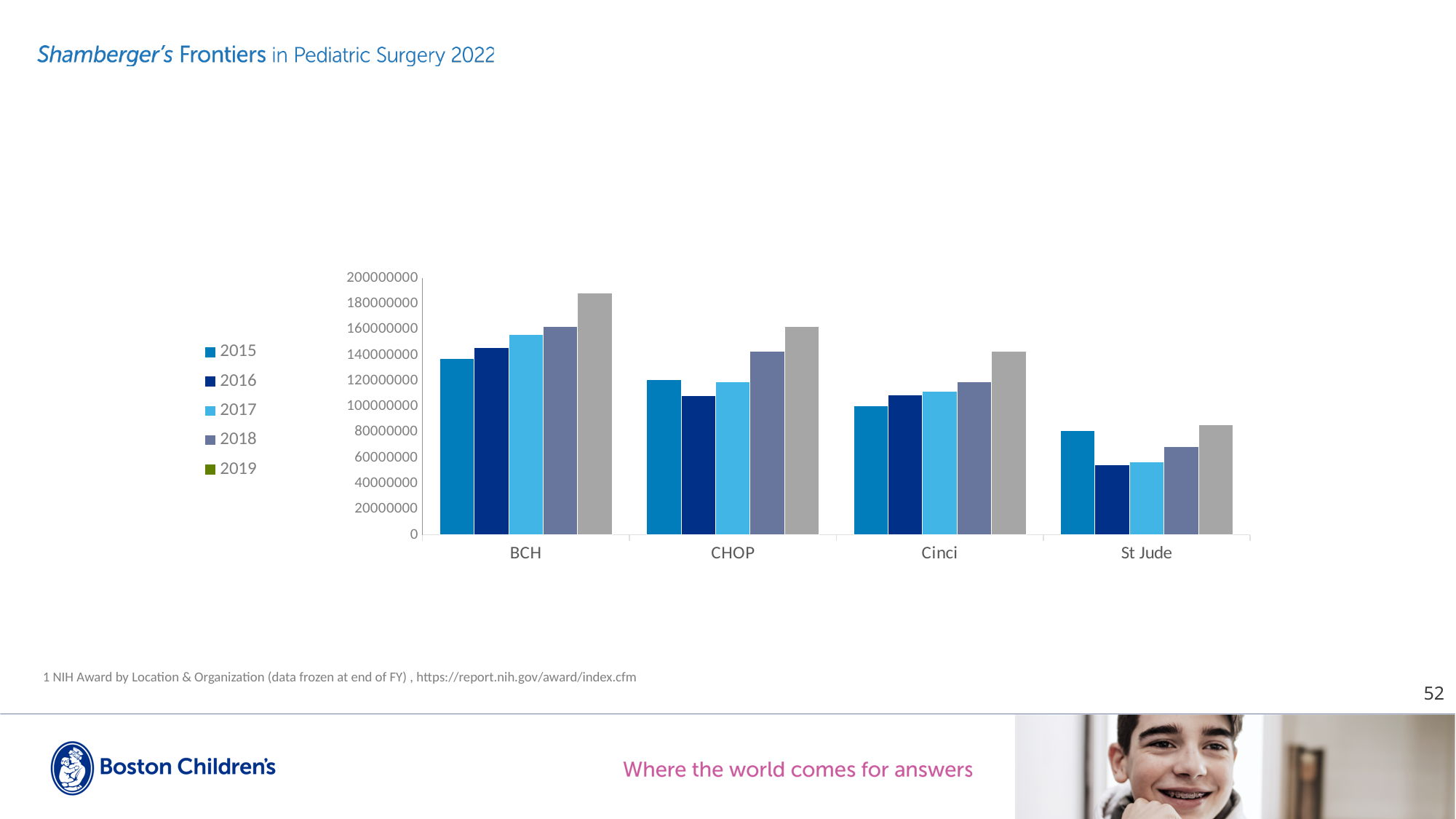
Which institution has the lowest bars overall? St Jude For BCH, which year has the highest value? 2019 Do the values for BCH rise or fall from 2015 to 2019? rise Is the 2016 value for St Jude greater or less than 60000000? less Which institution has the tallest bar in the chart? BCH What kind of chart is shown on the slide? bar chart Which is larger, the 2019 value for BCH or the 2019 value for CHOP? BCH How many institutions (categories) are shown on the x axis? 4 Is the 2019 value for Cinci greater or less than 120000000? greater Is the 2019 value for BCH greater or less than 180000000? greater How many series does the legend list? 5 For St Jude, which year has the lowest value? 2016